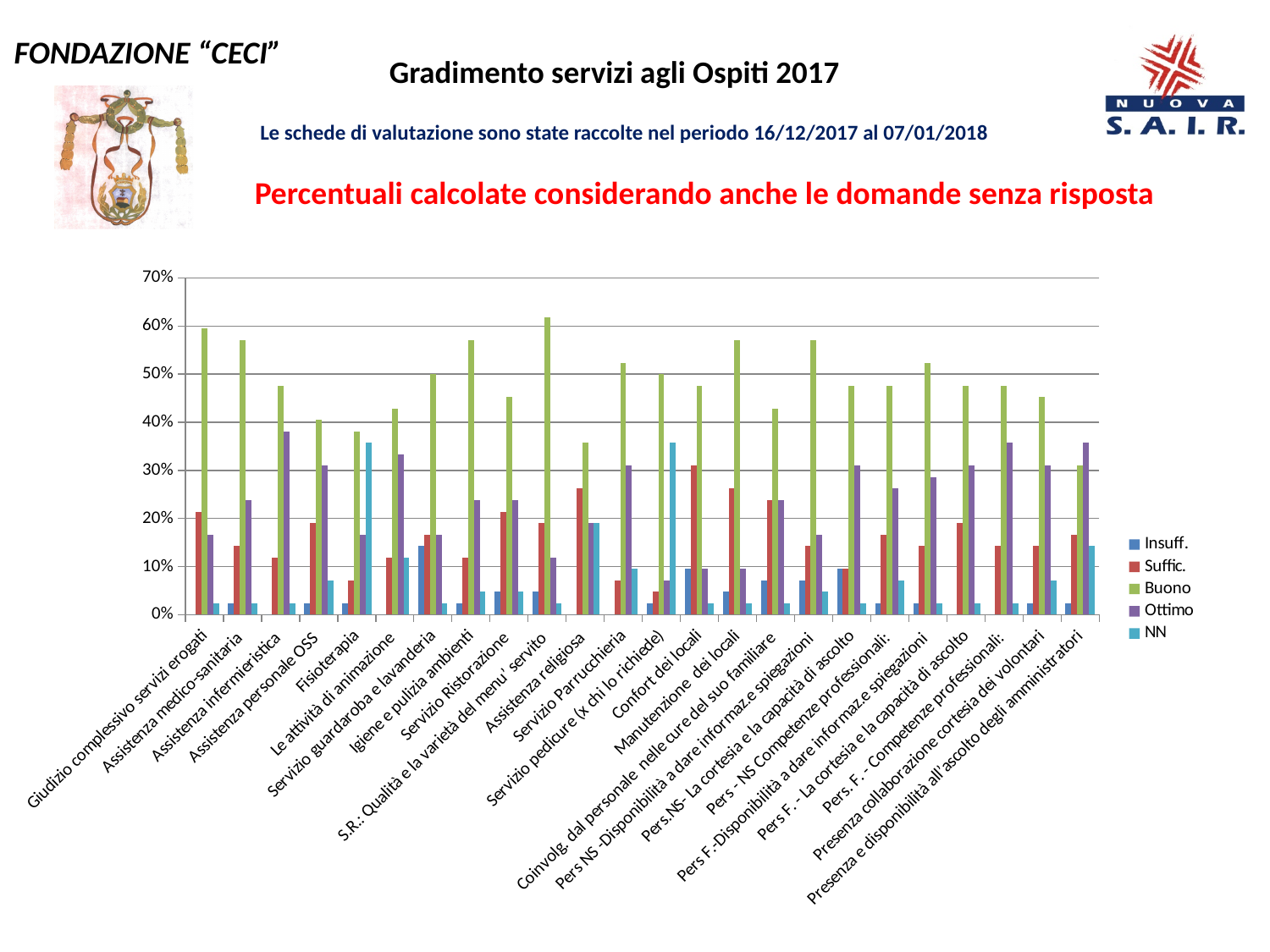
How many series does the chart legend list? 5 Is the NN value for Servizio pedicure (x chi lo richiede) greater or less than 30%? greater Is the Buono value for Giudizio complessivo servizi erogati greater or less than 50%? greater Which has the larger Ottimo value: Assistenza infermieristica or Servizio Ristorazione? Assistenza infermieristica What kind of chart is shown on the slide? Bar chart Which series is shown in green in the chart legend? Buono Which category has the highest Buono value? S.R.: Qualità e la varietà del menu' servito How many service categories are plotted along the x axis? 24 Which has the larger Buono value: Assistenza medico-sanitaria or Fisioterapia? Assistenza medico-sanitaria Is the Suffic. value for Confort dei locali greater or less than 20%? greater What is the title of the chart on the slide? Gradimento servizi agli Ospiti 2017